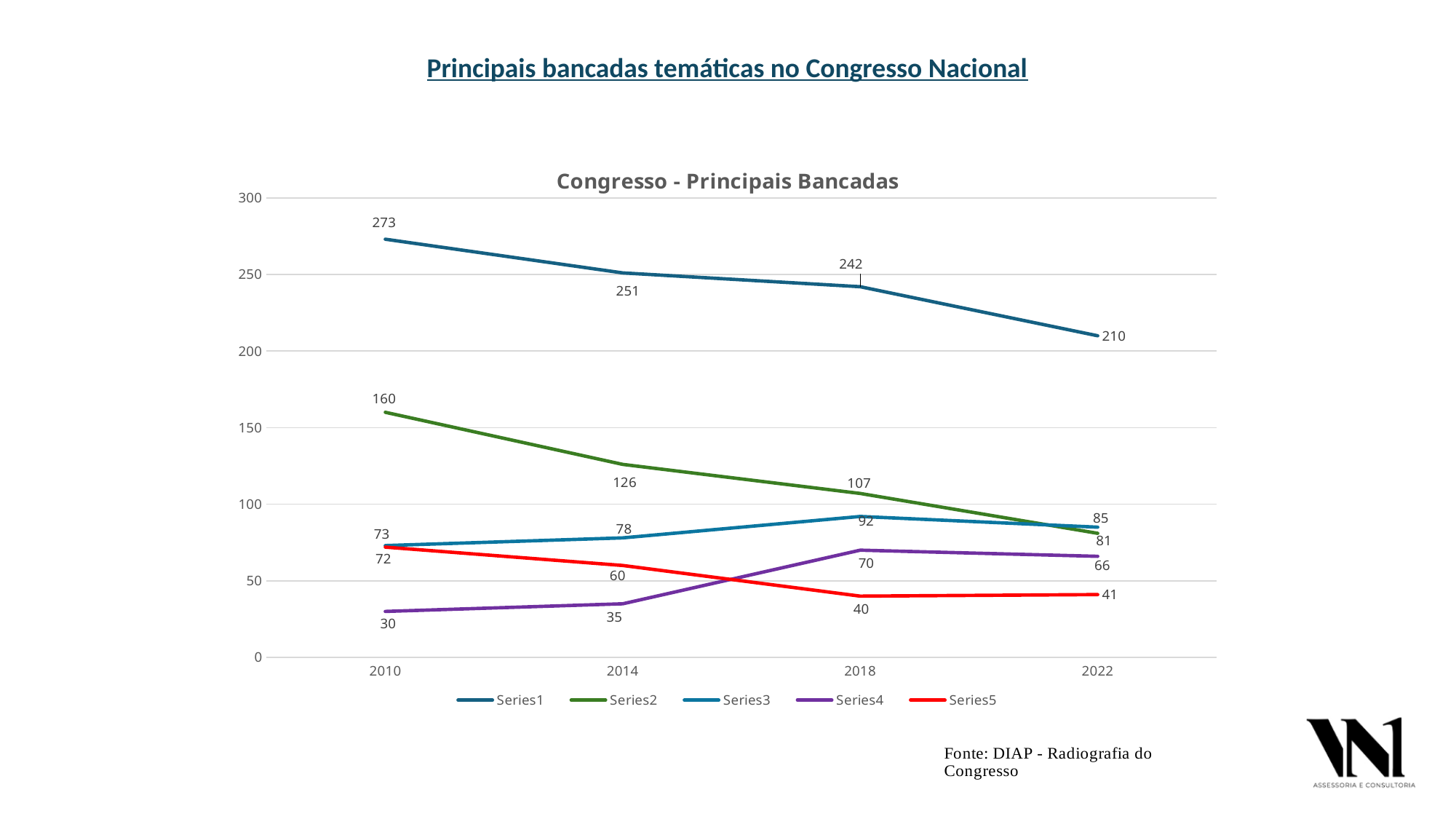
How many series does the legend list? 5 What is the value of Series4 in 2018? 70 What is the value of Series2 in 2022? 81 Does Series2 rise or fall from 2010 to 2022? fall What is the difference between the Series1 values in 2010 and 2022? 63 How many years are shown on the x axis? 4 Which series has the highest value in 2022? Series1 Which is larger in 2022, Series3 or Series2? Series3 What is the value of Series5 in 2014? 60 Which series has the lowest value in 2010? Series4 What kind of chart is shown? line chart What is the value of Series1 in 2010? 273